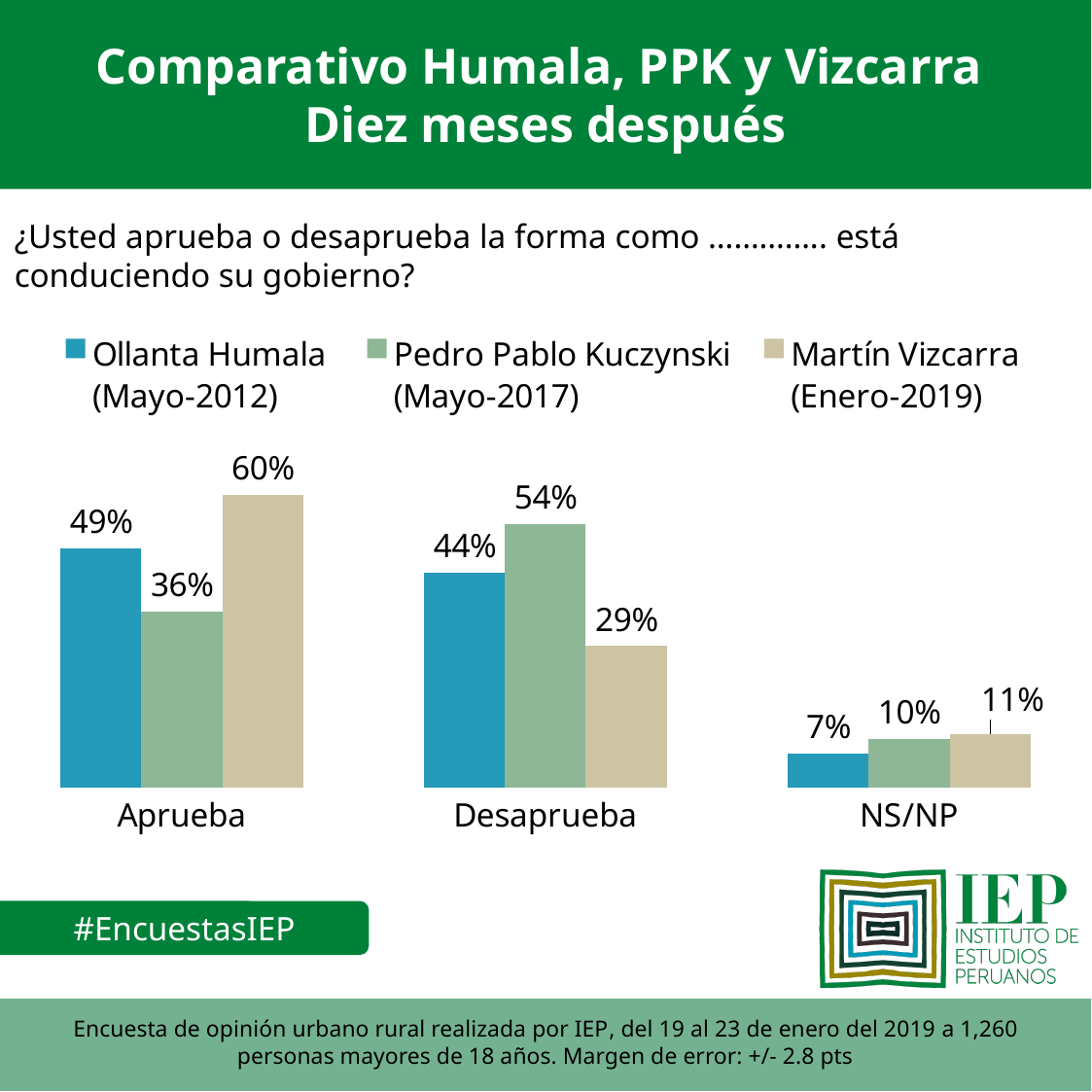
Which is larger: Ollanta Humala's Aprueba value or his Desaprueba value? Aprueba How many categories are shown on the x axis? 3 What is the value for Pedro Pablo Kuczynski (Mayo-2017) in the NS/NP category? 10% What is the difference between Martín Vizcarra's and Ollanta Humala's values in the Aprueba category? 11% Which series has the lowest value in the Aprueba category? Pedro Pablo Kuczynski (Mayo-2017) Which series has the highest value in the Desaprueba category? Pedro Pablo Kuczynski (Mayo-2017) What kind of chart is shown on the slide? Bar chart What is the difference between Pedro Pablo Kuczynski's and Martín Vizcarra's values in the Desaprueba category? 25% Which series is shown in blue in the legend? Ollanta Humala (Mayo-2012) How many series does the legend list? 3 What is the value for Martín Vizcarra (Enero-2019) in the Aprueba category? 60% What is the value for Ollanta Humala (Mayo-2012) in the Desaprueba category? 44%